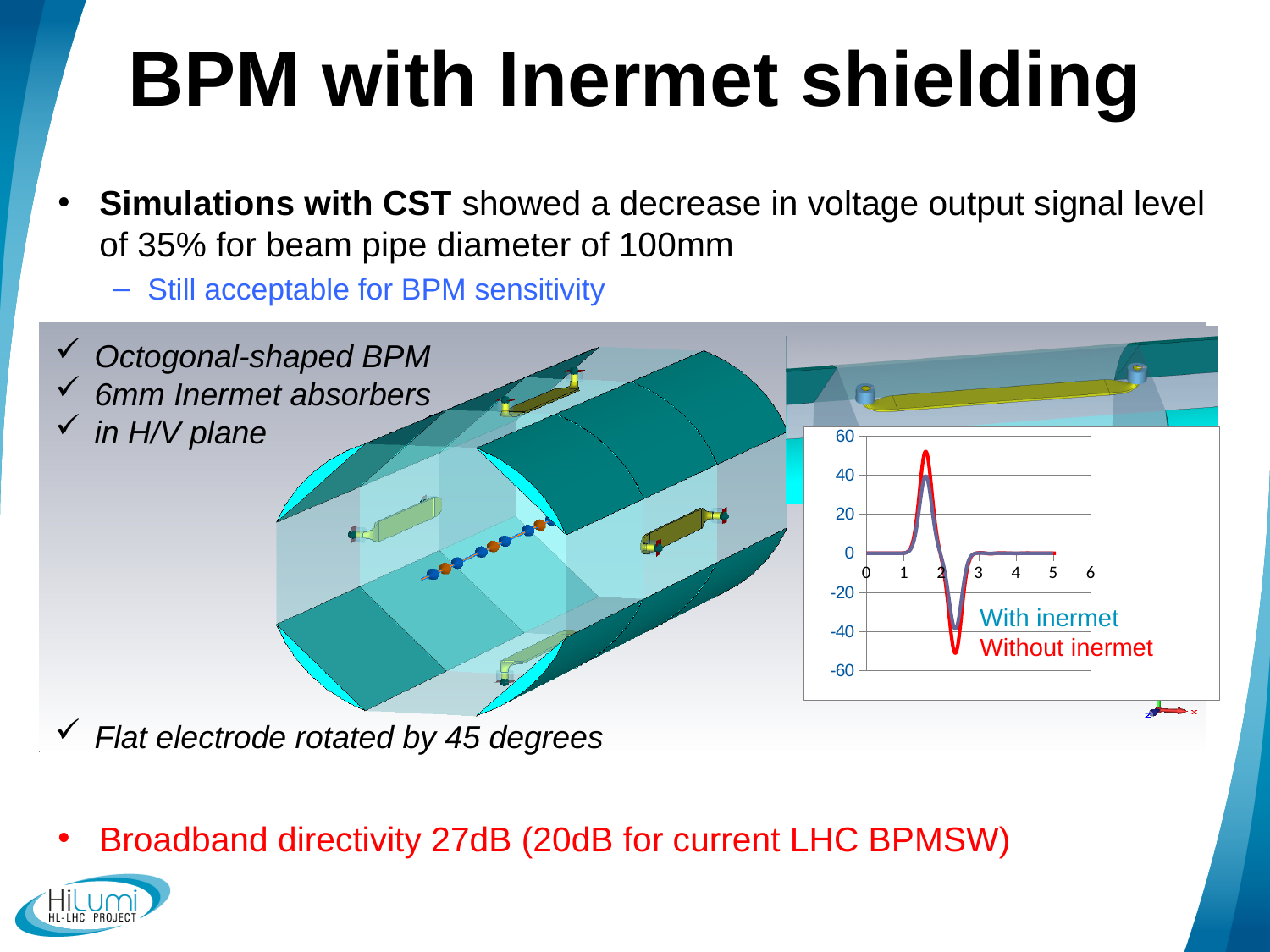
How many series does the chart on the right show? 2 In the chart on the right, which colour is used for the 'Without inermet' series? red What are the names of the two series in the chart on the right? With inermet, Without inermet In the chart on the right, is the negative minimum of the 'With inermet' series greater or less than -60? greater In the chart on the right, which series reaches the lower negative minimum, 'With inermet' or 'Without inermet'? Without inermet In the chart on the right, is the negative minimum of the 'Without inermet' series greater or less than -40? less In the chart on the right, is the positive peak of the 'Without inermet' series greater or less than 40? greater In the chart on the right, what is the maximum value shown on the y axis? 60 In the chart on the right, which series reaches the higher positive peak, 'With inermet' or 'Without inermet'? Without inermet What kind of chart is shown on the right side of the slide? line chart